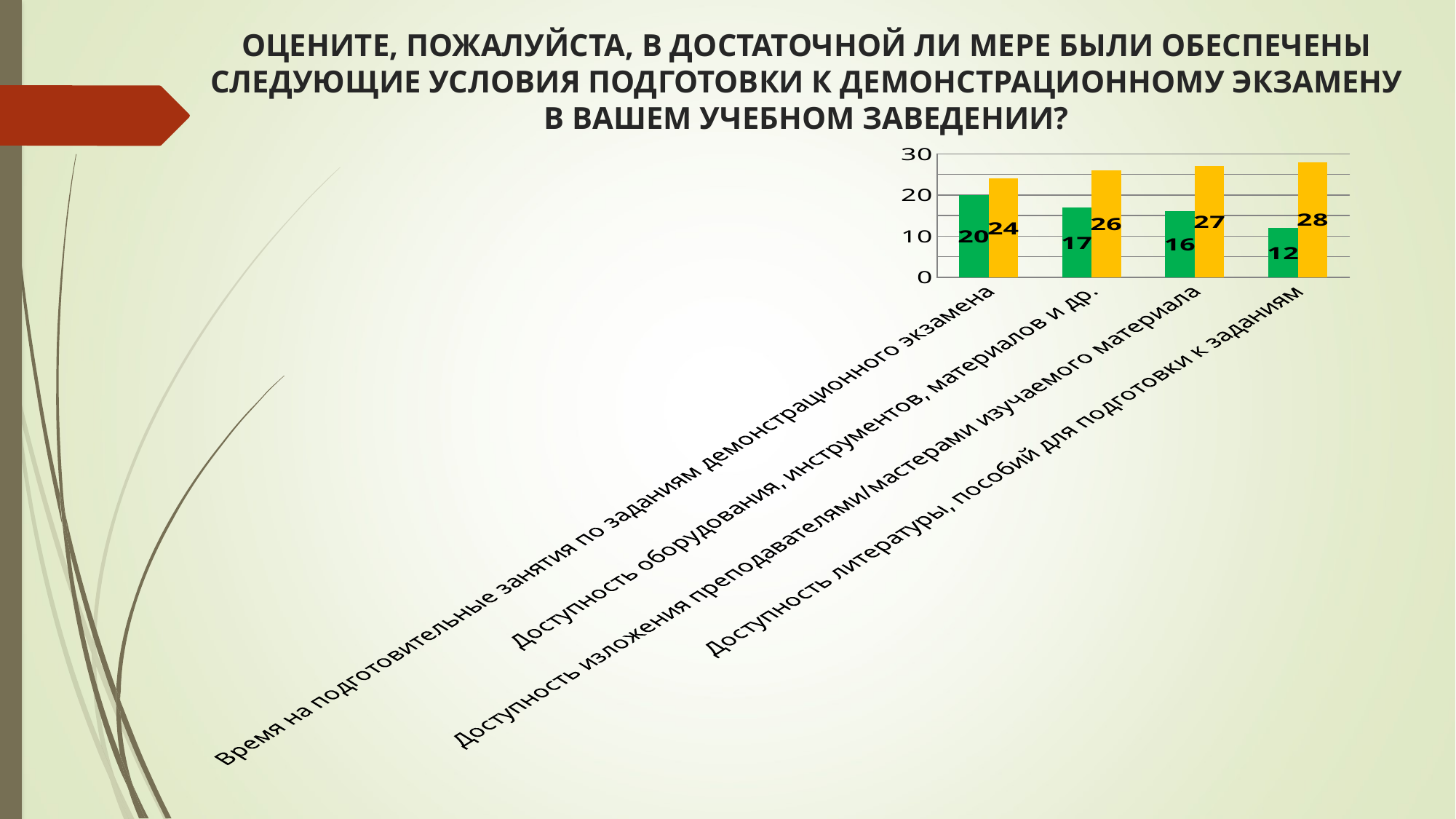
What is the value of the green bar for "Доступность литературы, пособий для подготовки к заданиям"? 12 Do the yellow bars rise or fall from left to right along the x axis? rise Which category has the highest yellow bar? Доступность литературы, пособий для подготовки к заданиям What is the difference between the yellow and green bars for "Доступность литературы, пособий для подготовки к заданиям"? 16 For "Время на подготовительные занятия по заданиям демонстрационного экзамена", which bar is larger, the green or the yellow? yellow What is the value of the yellow bar for "Доступность изложения преподавателями/мастерами изучаемого материала"? 27 What is the value of the yellow bar for "Доступность оборудования, инструментов, материалов и др."? 26 What is the value of the green bar for "Время на подготовительные занятия по заданиям демонстрационного экзамена"? 20 Which category has the lowest green bar? Доступность литературы, пособий для подготовки к заданиям How many categories are shown on the x axis of the chart? 4 What kind of chart is shown on the slide? bar chart Do the green bars rise or fall from left to right along the x axis? fall